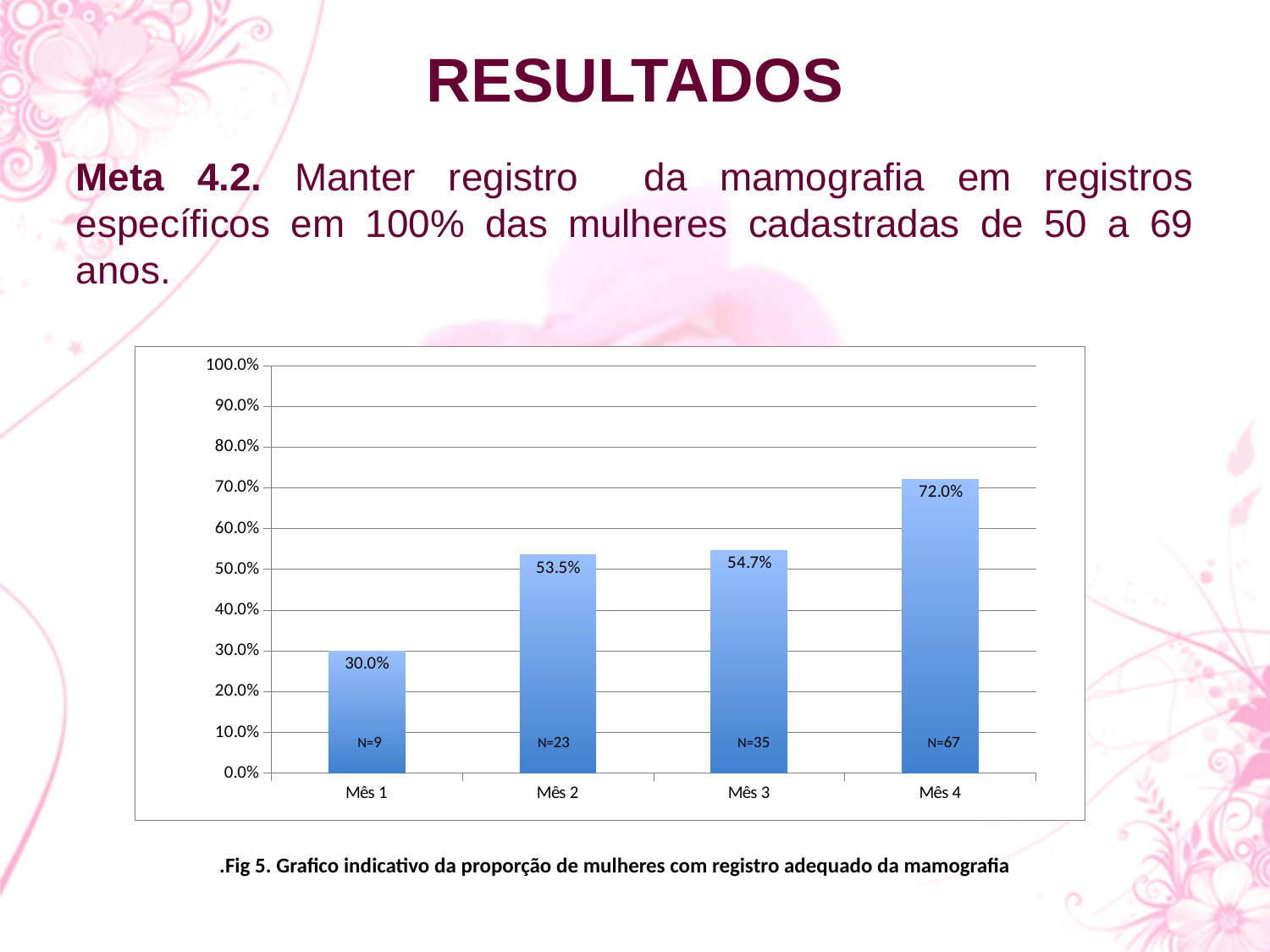
What is the difference between the values for Mês 4 and Mês 1? 42.0% Do the values rise or fall from Mês 1 to Mês 4? rise Is the value for Mês 3 greater or less than 50.0%? greater What kind of chart is shown? bar chart What N value is printed inside the bar for Mês 3? N=35 What is the value for Mês 4? 72.0% Which month has the lowest value? Mês 1 What is the value for Mês 1? 30.0% What is the value for Mês 2? 53.5% Which month has the highest value? Mês 4 Which is larger, the value for Mês 2 or Mês 4? Mês 4 How many months are shown on the x axis? 4